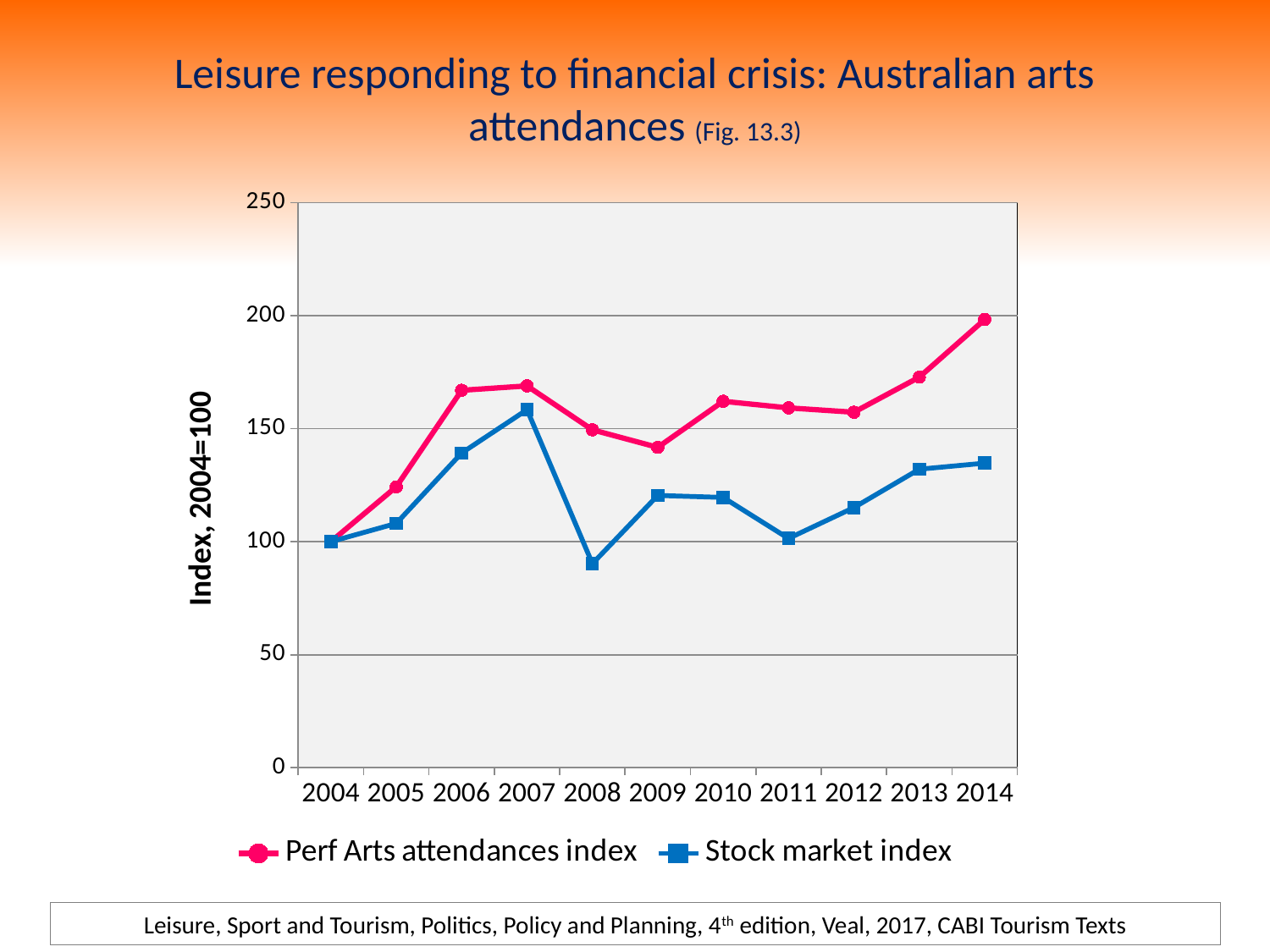
What is the label of the y axis? Index, 2004=100 Is the value of the Perf Arts attendances index in 2014 greater or less than 150? greater In which year is the Stock market index highest? 2007 What kind of chart is shown on the slide? Line chart How many years are plotted along the x axis? 11 What is the value of the Stock market index in 2004? 100 How many series does the legend list? 2 What is the value of the Perf Arts attendances index in 2004? 100 In 2008, which series has the larger value: Perf Arts attendances index or Stock market index? Perf Arts attendances index In which year is the Stock market index lowest? 2008 Is the value of the Stock market index in 2008 greater or less than 100? less In which year is the Perf Arts attendances index highest? 2014